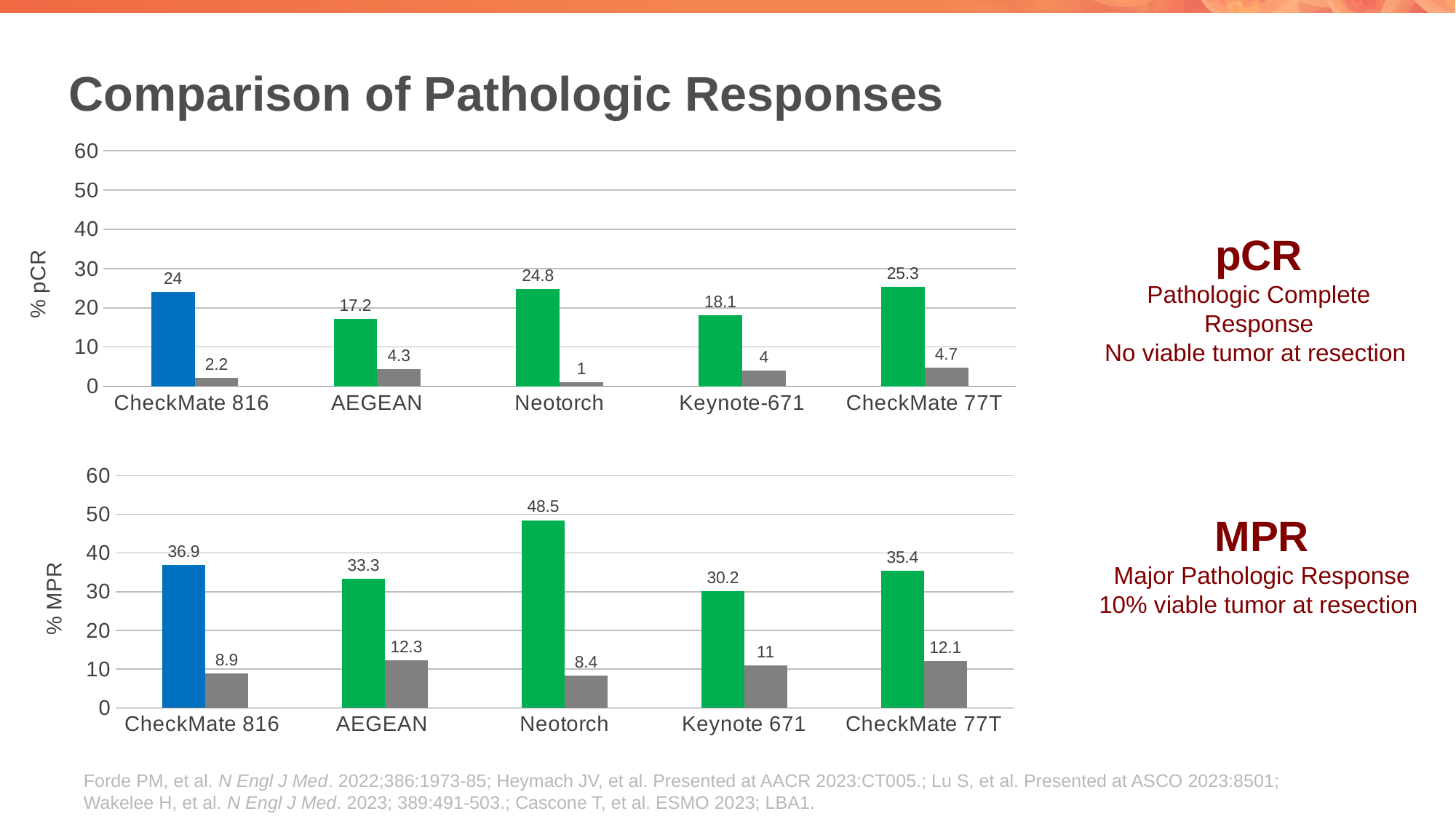
In the bottom (% MPR) chart, which trial has the highest green bar? Neotorch In the bottom (% MPR) chart, what is the difference between the green bar and the gray bar for Neotorch? 40.1 In the top (% pCR) chart, what is the value of the gray bar for AEGEAN? 4.3 In the bottom (% MPR) chart, is the value of the blue bar for CheckMate 816 greater or less than 30? greater In the top (% pCR) chart, which trial has the highest coloured (non-gray) bar? CheckMate 77T In the top (% pCR) chart, what is the value of the green bar for Neotorch? 24.8 In the top (% pCR) chart, what is the difference between the blue bar and the gray bar for CheckMate 816? 21.8 In the bottom (% MPR) chart, what is the value of the green bar for Keynote 671? 30.2 In the top (% pCR) chart, which trial has the lowest gray bar? Neotorch How many trials are shown on the x axis of the top (% pCR) chart? 5 What type of chart is the bottom (% MPR) chart? Bar chart In the bottom (% MPR) chart, which is larger: the gray bar for AEGEAN or the gray bar for CheckMate 77T? AEGEAN